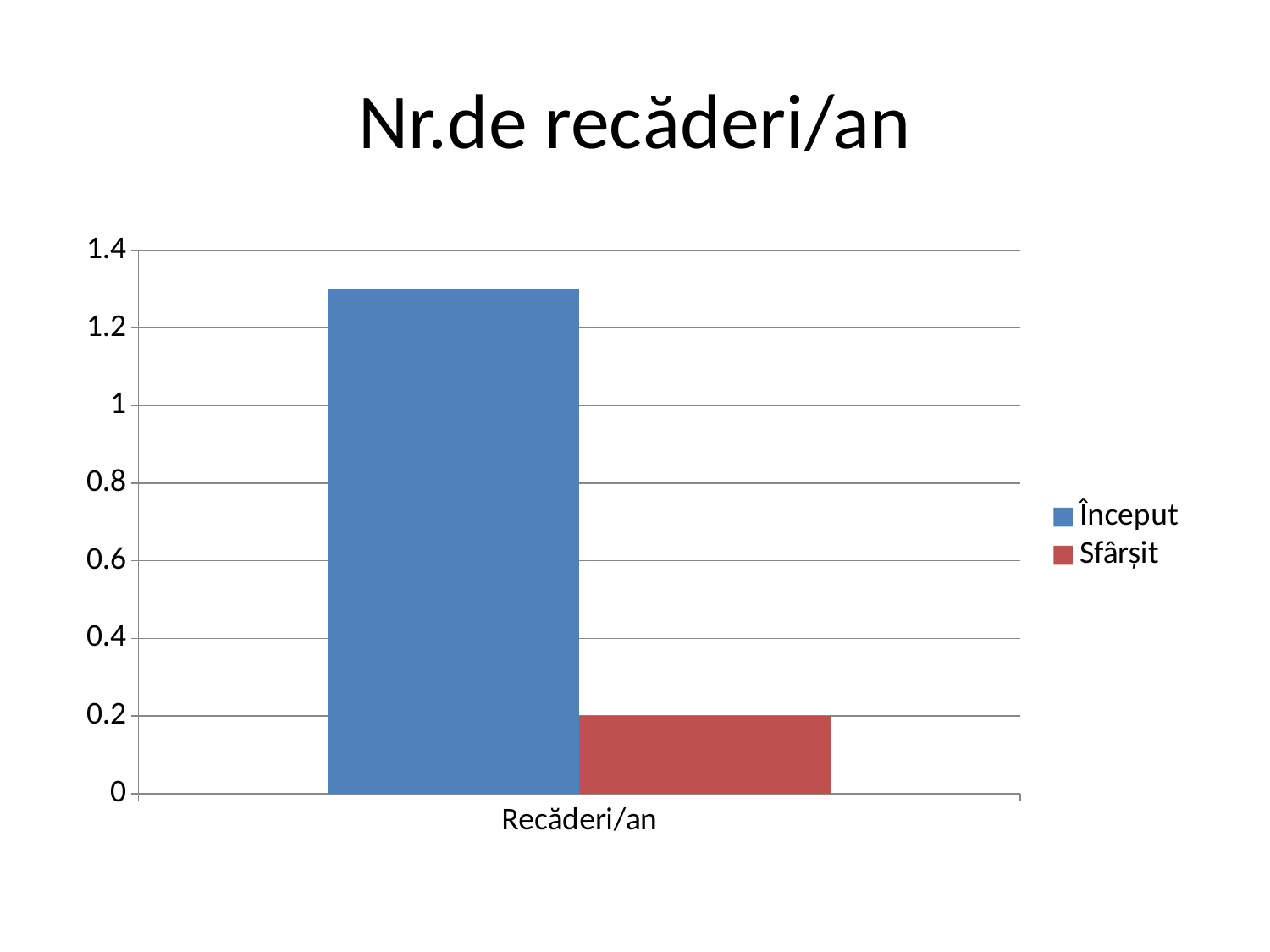
How many categories are shown on the x axis? 1 How many series does the legend list? 2 Which series has the higher value, Început or Sfârșit? Început What is the value for Sfârșit? 0.2 Is the value for Început greater or less than 1.4? less What is the title of the chart? Nr.de recăderi/an Which series has the lowest value? Sfârșit Which series has the highest value? Început What is the label of the category on the x axis? Recăderi/an What colour is the bar for Sfârșit? red What type of chart is shown on the slide? bar chart Is the value for Început greater or less than 1.2? greater